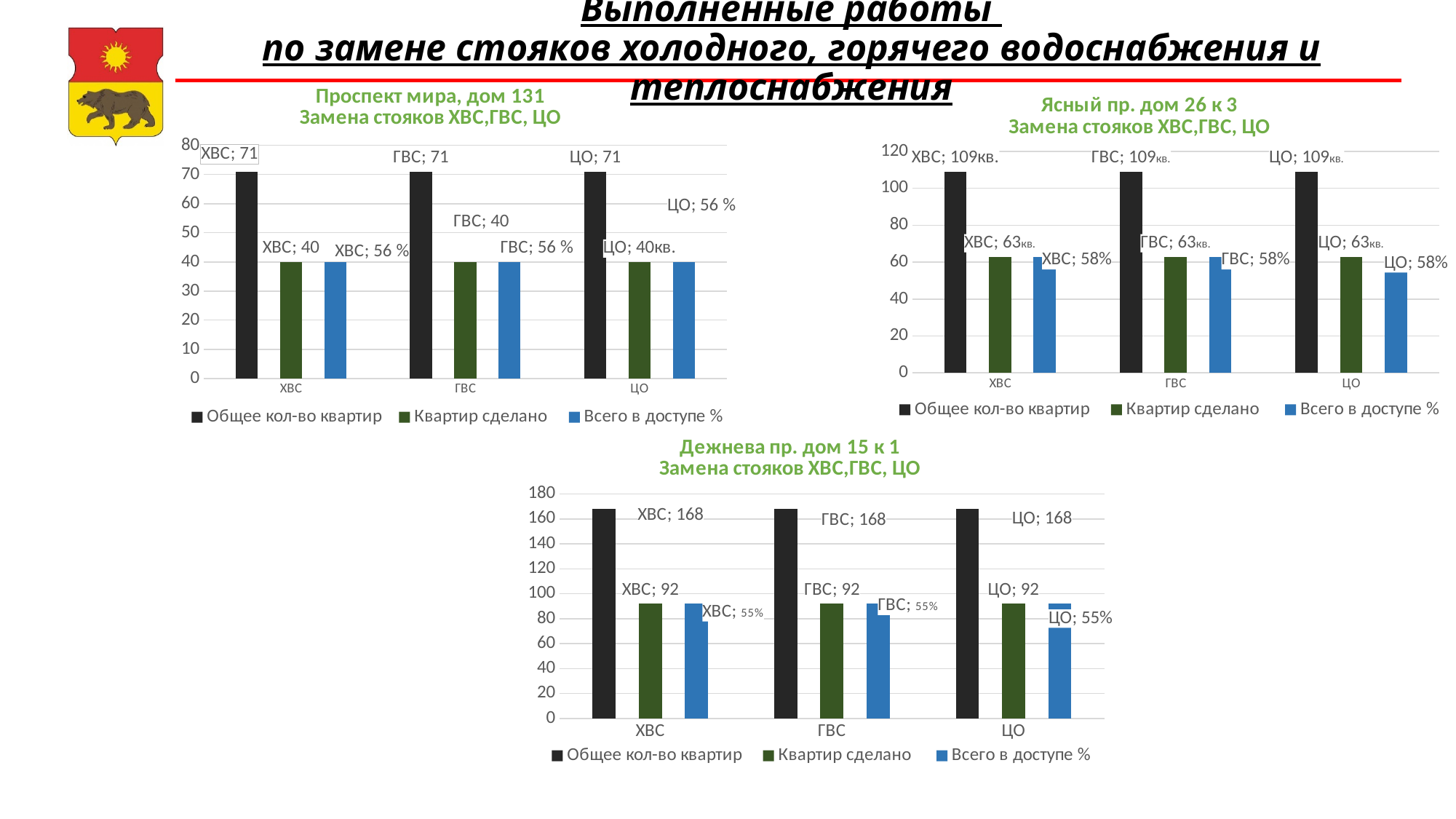
In the chart titled 'Ясный пр. дом 26 к 3', what is the value of 'Общее кол-во квартир' for ХВС? 109кв. What kind of chart is the one titled 'Проспект мира, дом 131'? bar chart How many series does the legend list in the chart titled 'Дежнева пр. дом 15 к 1'? 3 In the chart titled 'Ясный пр. дом 26 к 3', what is the value of 'Всего в доступе %' for ЦО? 58% How many categories are shown on the x axis of the chart titled 'Ясный пр. дом 26 к 3'? 3 In the chart titled 'Дежнева пр. дом 15 к 1', what is the value of 'Общее кол-во квартир' for ЦО? 168 In the chart titled 'Проспект мира, дом 131', what is the value of 'Общее кол-во квартир' for ХВС? 71 In the chart titled 'Дежнева пр. дом 15 к 1', what is the value of 'Квартир сделано' for ХВС? 92 In the chart titled 'Проспект мира, дом 131', what is the value of 'Квартир сделано' for ГВС? 40 In the chart titled 'Проспект мира, дом 131', what is the difference between 'Общее кол-во квартир' and 'Квартир сделано' for ЦО? 31 In the chart titled 'Дежнева пр. дом 15 к 1', is the value of 'Общее кол-во квартир' for ГВС greater or less than 160? greater In the chart titled 'Ясный пр. дом 26 к 3', which is larger for ГВС: 'Квартир сделано' or 'Всего в доступе %'? Квартир сделано